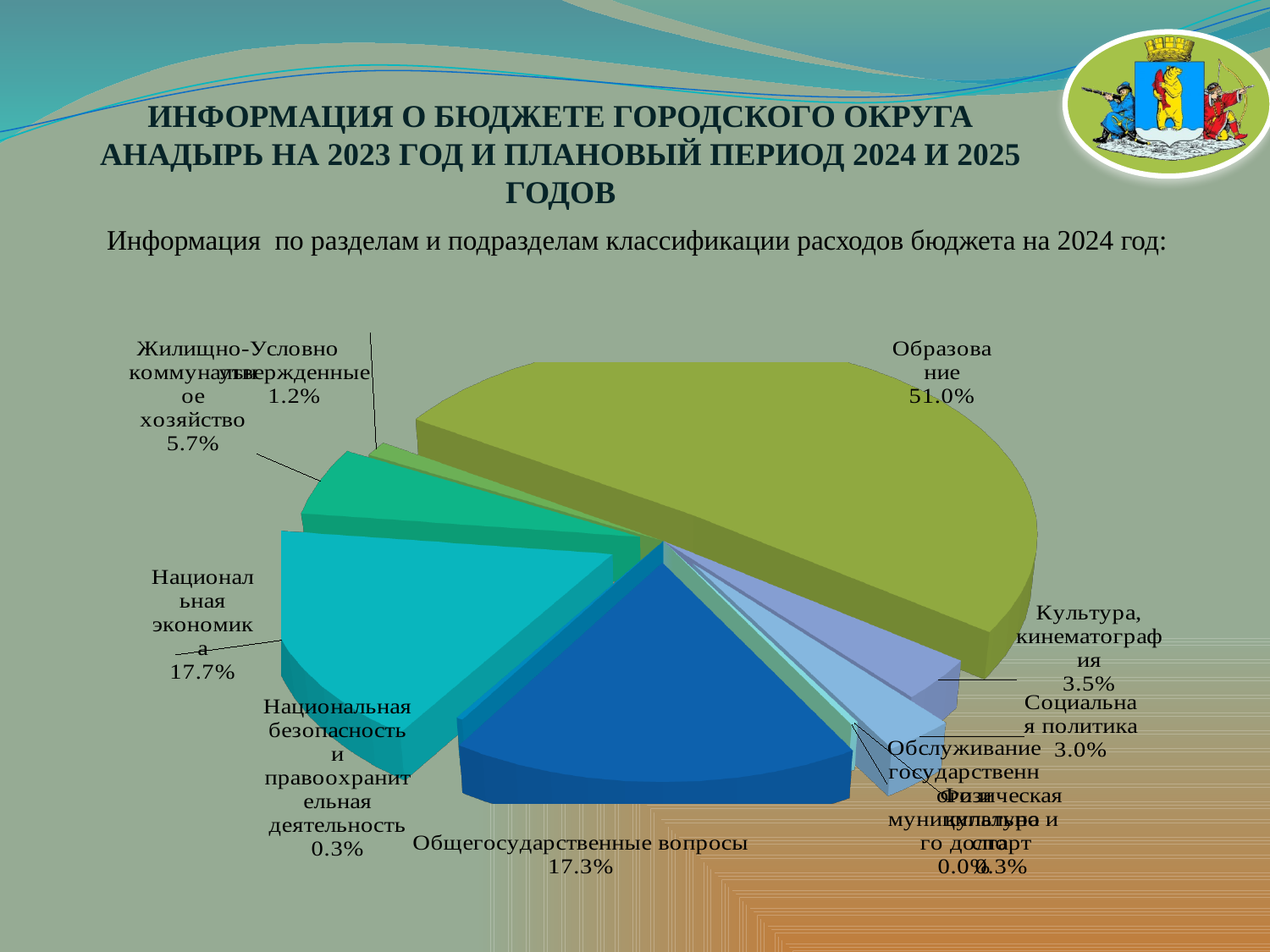
What share is shown for Жилищно-коммунальное хозяйство? 5.7% What share is shown for Условно утвержденные? 1.2% Which is larger: the share for Национальная экономика or for Общегосударственные вопросы? Национальная экономика What share is shown for Социальная политика? 3.0% What share is shown for Национальная экономика? 17.7% Which section has the largest share of the pie? Образование What kind of chart is shown on the slide? pie chart What is the difference between the shares for Образование and Национальная экономика? 33.3% What share of the 2024 budget expenditures goes to Образование? 51.0% What share is shown for Общегосударственные вопросы? 17.3% How many sections (slices) are shown in the pie chart? 10 What share is shown for Культура, кинематография? 3.5%